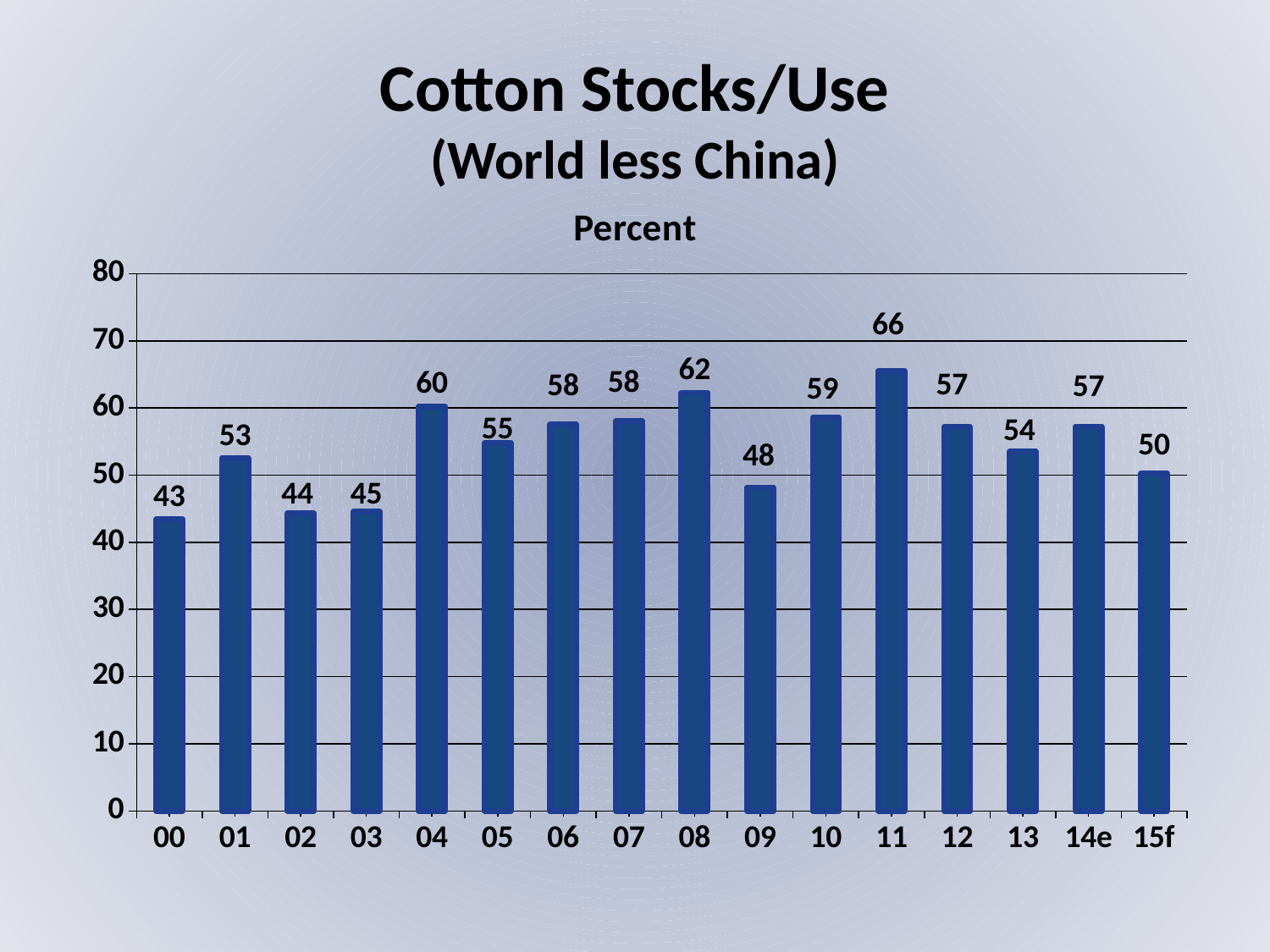
What is the value shown for 00? 43 Do the values rise or fall from 00 to 04? rise How many years are shown on the x axis? 16 Which year has the lowest stocks/use value? 00 What kind of chart is shown? bar chart What is the cotton stocks/use value for 11? 66 Which is larger, the value for 04 or the value for 05? 04 What is the title of the chart? Cotton Stocks/Use (World less China) Which year has the highest stocks/use value? 11 Is the value for 08 greater or less than 60? greater What is the difference between the values for 11 and 09? 18 What is the value shown for 15f? 50